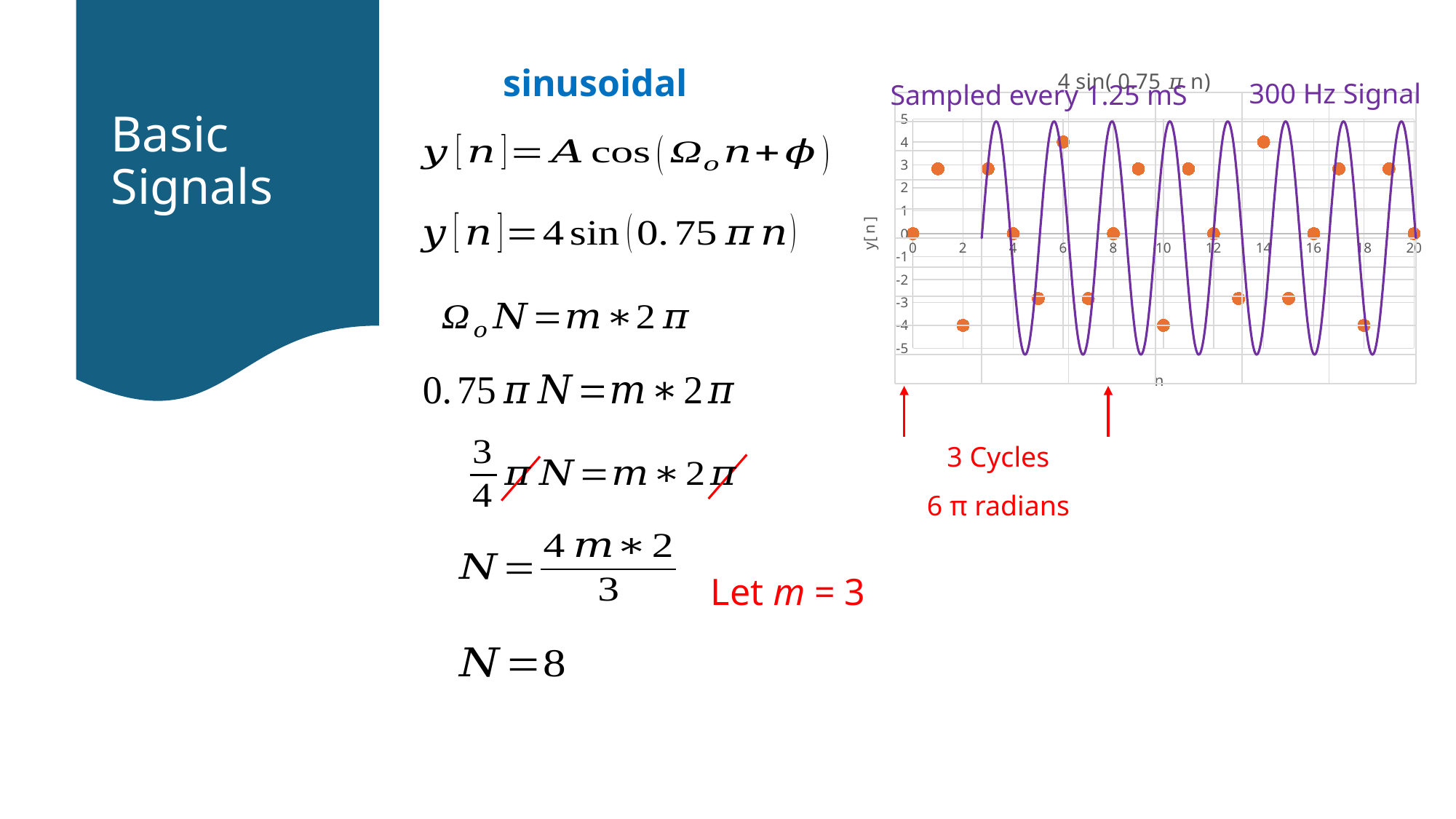
Is the value of the sample point at n = 5 greater or less than -2? less What is the label of the y axis of the chart? y[n] What is the value of the orange sample point at n = 10? -4 Which sample point has the larger value, n = 2 or n = 6? n = 6 What is the title of the chart? 4 sin(0.75 π n) What is the value of the orange sample point at n = 14? 4 What is the difference between the sample values at n = 6 and n = 2? 8 What is the value of the orange sample point at n = 8? 0 Is the value of the sample point at n = 1 greater or less than 2? greater What is the value of the orange sample point at n = 2? -4 What is the highest value shown on the y axis of the chart? 5 What is the value of the orange sample point at n = 6? 4